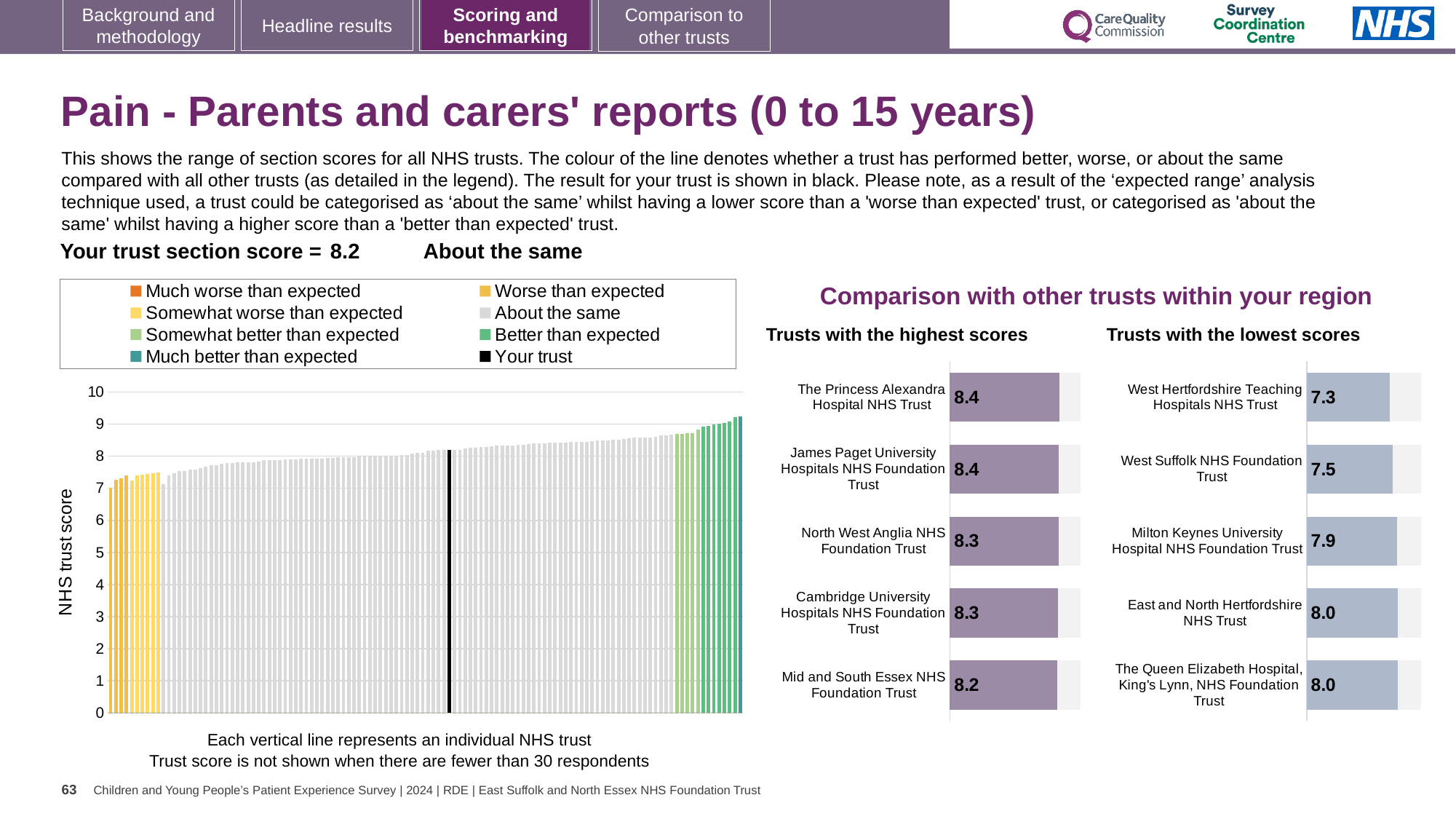
In the 'Trusts with the highest scores' chart, what is the score for North West Anglia NHS Foundation Trust? 8.3 In the 'Trusts with the lowest scores' chart, which trust has the highest score, Milton Keynes University Hospital NHS Foundation Trust or West Hertfordshire Teaching Hospitals NHS Trust? Milton Keynes University Hospital NHS Foundation Trust What kind of chart is the main chart on the left showing the range of section scores? Bar chart In the 'Trusts with the lowest scores' chart, which trust has the lowest score? West Hertfordshire Teaching Hospitals NHS Trust In the 'Trusts with the highest scores' chart, what is the difference between the score for The Princess Alexandra Hospital NHS Trust and the score for Mid and South Essex NHS Foundation Trust? 0.2 In the 'Trusts with the lowest scores' chart, what is the score for West Suffolk NHS Foundation Trust? 7.5 How many entries does the legend of the main chart on the left list? 8 In the main chart on the left, do the trust scores rise or fall from left to right? Rise In the main chart on the left, is the value for the black 'Your trust' bar greater or less than 8? greater How many trusts are listed in the 'Trusts with the highest scores' chart? 5 In the 'Trusts with the lowest scores' chart, what is the difference between the score for Milton Keynes University Hospital NHS Foundation Trust and the score for West Hertfordshire Teaching Hospitals NHS Trust? 0.6 What is the y-axis label of the main chart on the left? NHS trust score